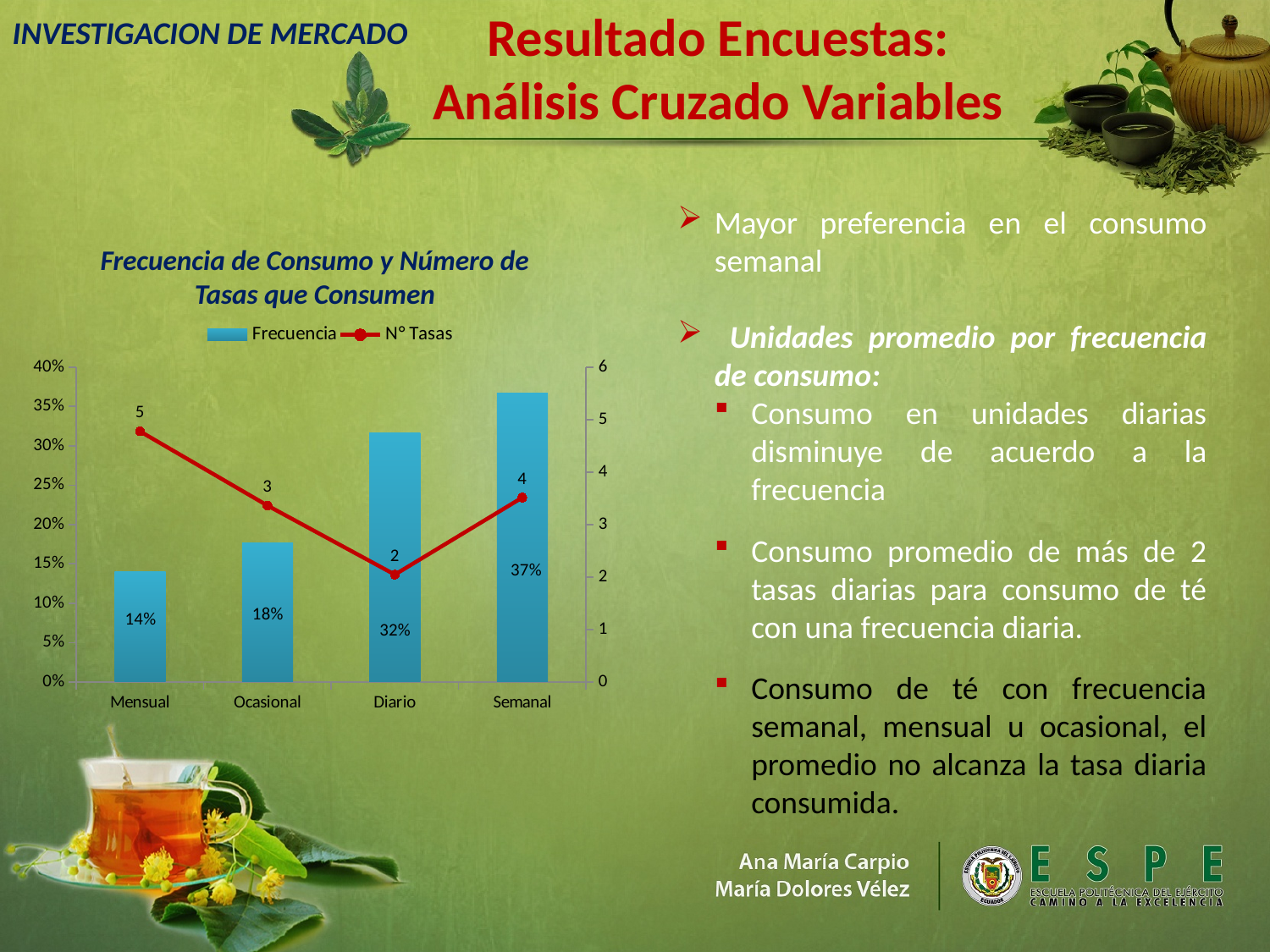
Which category has the highest Frecuencia? Semanal What is the Frecuencia value for Ocasional? 18% How many categories are shown on the x axis? 4 What is the difference in Frecuencia between Diario and Mensual? 18% What is the N° Tasas value for Mensual? 5 What kind of chart is this? Combined bar and line chart Which has a higher N° Tasas, Ocasional or Semanal? Semanal Which category has the lowest N° Tasas? Diario What is the N° Tasas value for Diario? 2 What is the title of the chart? Frecuencia de Consumo y Número de Tasas que Consumen What is the Frecuencia value for Semanal? 37% How many series does the legend list? 2